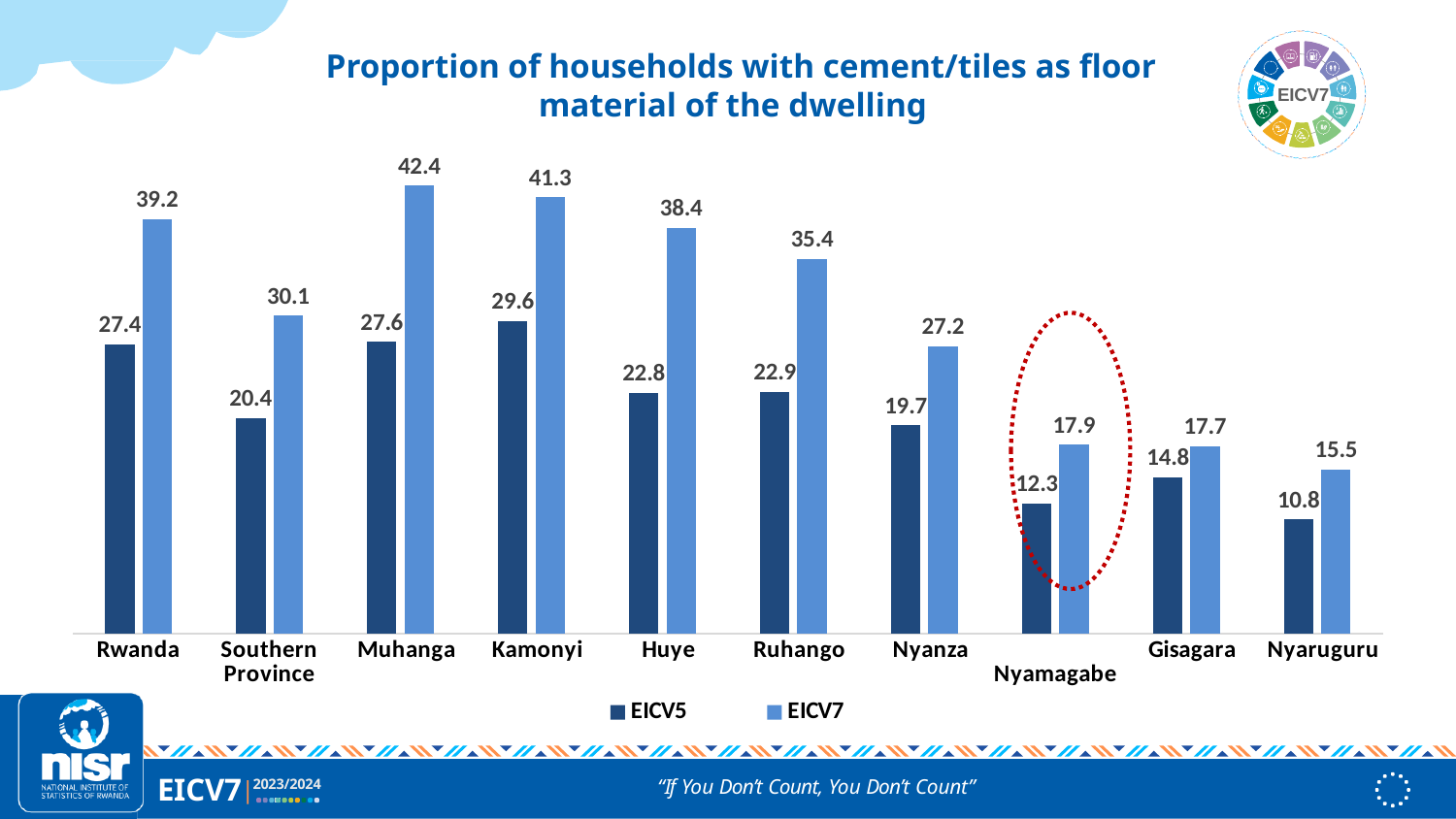
Which category has the lowest EICV5 value? Nyaruguru What is the title of the chart? Proportion of households with cement/tiles as floor material of the dwelling Which is larger, the EICV7 value for Huye or the EICV7 value for Ruhango? Huye What kind of chart is shown on the slide? Bar chart What is the EICV7 value for Southern Province? 30.1 How many series does the legend list? 2 What is the difference between the EICV7 and EICV5 values for Rwanda? 11.8 Which category has the highest EICV7 value? Muhanga What is the EICV7 value for Muhanga? 42.4 What is the difference between the EICV7 values for Kamonyi and Nyaruguru? 25.8 What is the EICV5 value for Nyamagabe? 12.3 How many categories are shown on the x axis? 10